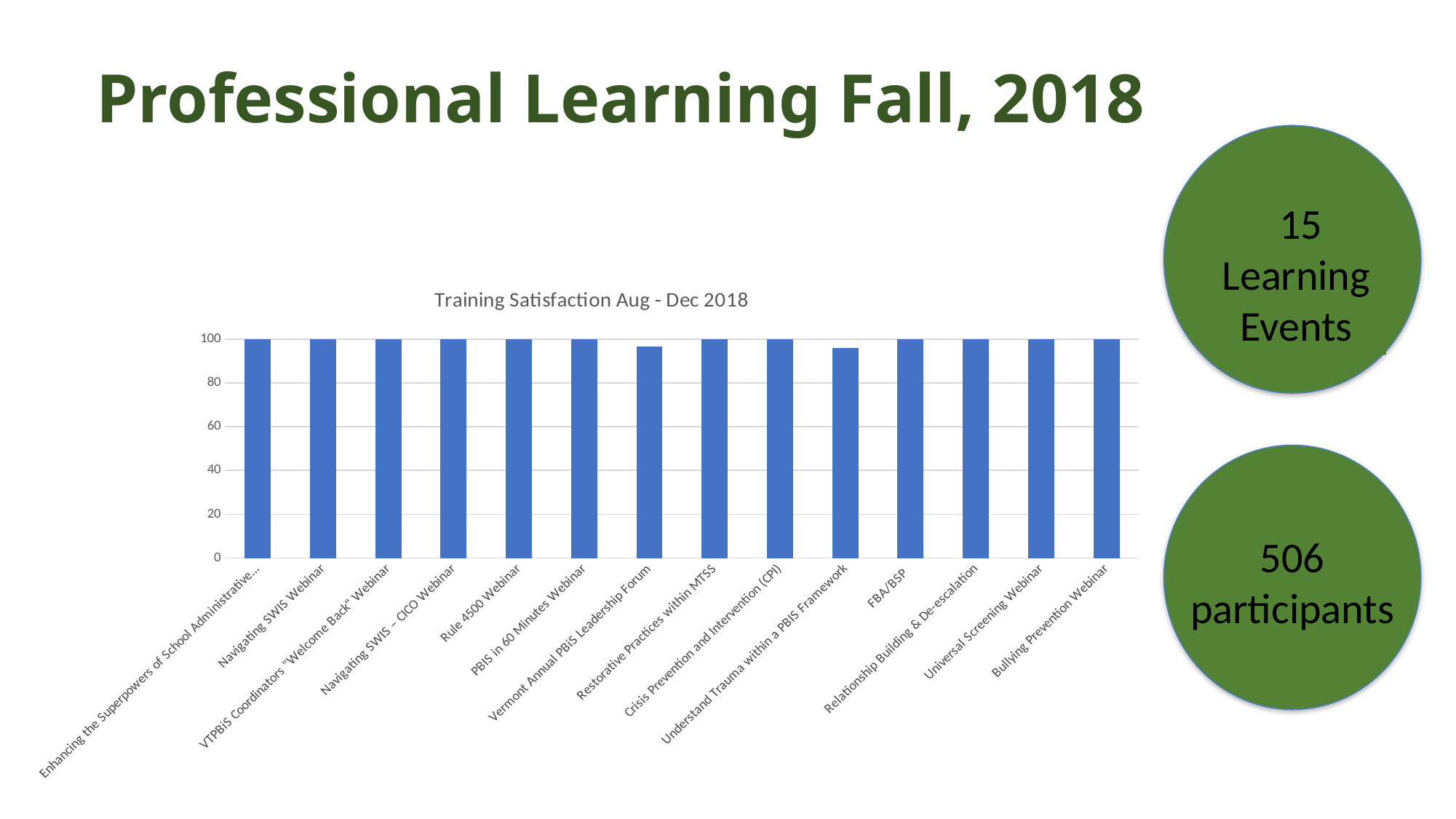
Is the value for Understand Trauma within a PBIS Framework greater or less than 80? greater Which is larger in the Training Satisfaction chart: the value for Understand Trauma within a PBIS Framework or the value for Universal Screening Webinar? Universal Screening Webinar What is the value for Rule 4500 Webinar in the Training Satisfaction chart? 100 What is the value for Bullying Prevention Webinar in the Training Satisfaction chart? 100 Which is larger in the Training Satisfaction chart: the value for Rule 4500 Webinar or the value for Vermont Annual PBiS Leadership Forum? Rule 4500 Webinar Is the value for Vermont Annual PBiS Leadership Forum greater or less than 100? less What is the difference between the value for Navigating SWIS Webinar and the value for Restorative Practices within MTSS? 0 What is the value for FBA/BSP in the Training Satisfaction chart? 100 What kind of chart is shown on the slide? bar chart How many categories (training events) are plotted in the Training Satisfaction chart? 14 What is the title of the chart on the slide? Training Satisfaction Aug - Dec 2018 What is the highest value shown on the vertical axis of the Training Satisfaction chart? 100